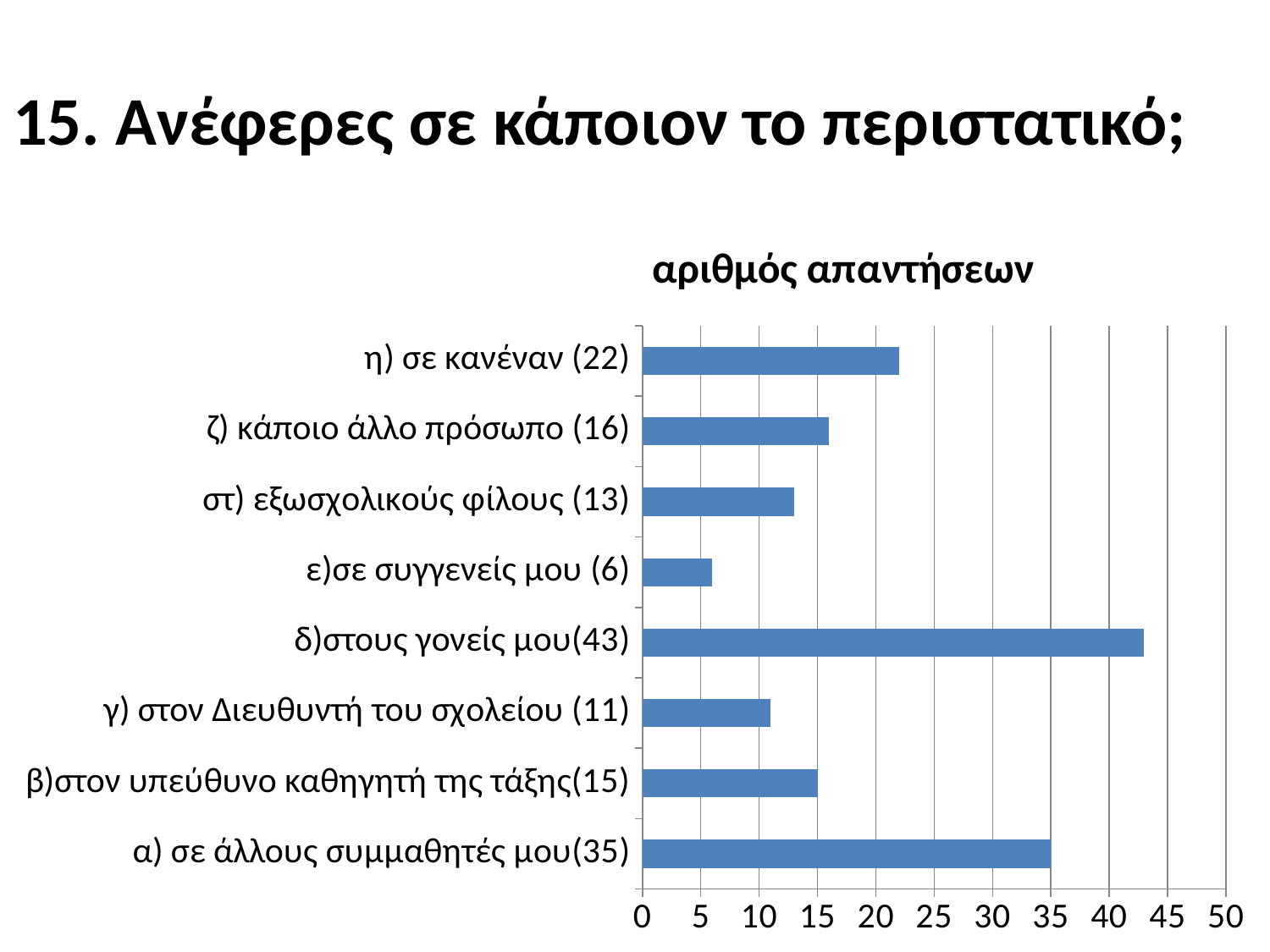
What is the difference between the values for 'δ)στους γονείς μου' and 'α) σε άλλους συμμαθητές μου'? 8 Is the value for 'στ) εξωσχολικούς φίλους' greater or less than 15? less Which category has the lowest value? ε)σε συγγενείς μου (6) How many categories are shown in the chart? 8 What type of chart is shown on the slide? bar chart Which is larger, the value for 'ζ) κάποιο άλλο πρόσωπο' or the value for 'β)στον υπεύθυνο καθηγητή της τάξης'? ζ) κάποιο άλλο πρόσωπο What is the value for 'γ) στον Διευθυντή του σχολείου'? 11 What is the difference between the values for 'η) σε κανέναν' and 'ε)σε συγγενείς μου'? 16 What is the value for 'α) σε άλλους συμμαθητές μου'? 35 What is the title of the chart? αριθμός απαντήσεων Which category has the highest value? δ)στους γονείς μου(43) What is the value for 'η) σε κανέναν'? 22